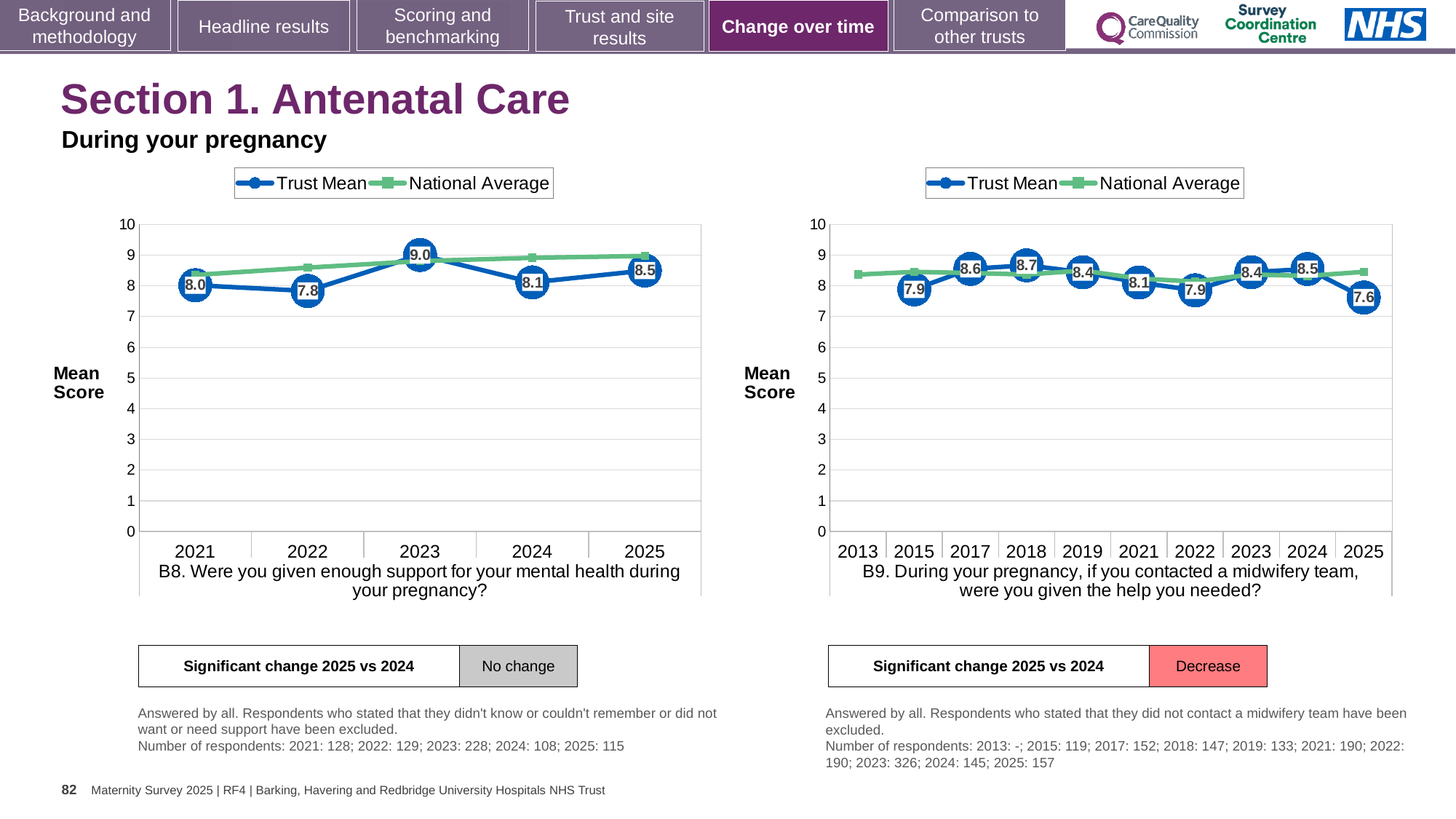
In the B8 chart on the left, how many years are shown on the x axis? 5 In the B9 chart on the right, which year has the lowest Trust Mean? 2025 In the B8 chart on the left, what is the Trust Mean for 2023? 9.0 In the B9 chart on the right, is the Trust Mean higher in 2017 or in 2021? 2017 How many series does the legend of the B9 chart on the right list? 2 In the B9 chart on the right, what is the Trust Mean for 2025? 7.6 In the B8 chart on the left, what is the Trust Mean for 2022? 7.8 What kind of chart is the B8 chart on the left? Line chart In the B8 chart on the left, what is the difference between the Trust Mean for 2025 and 2024? 0.4 In the B9 chart on the right, which year has the highest Trust Mean? 2018 In the B9 chart on the right, how many years are shown on the x axis? 10 In the B8 chart on the left, which year has the highest Trust Mean? 2023